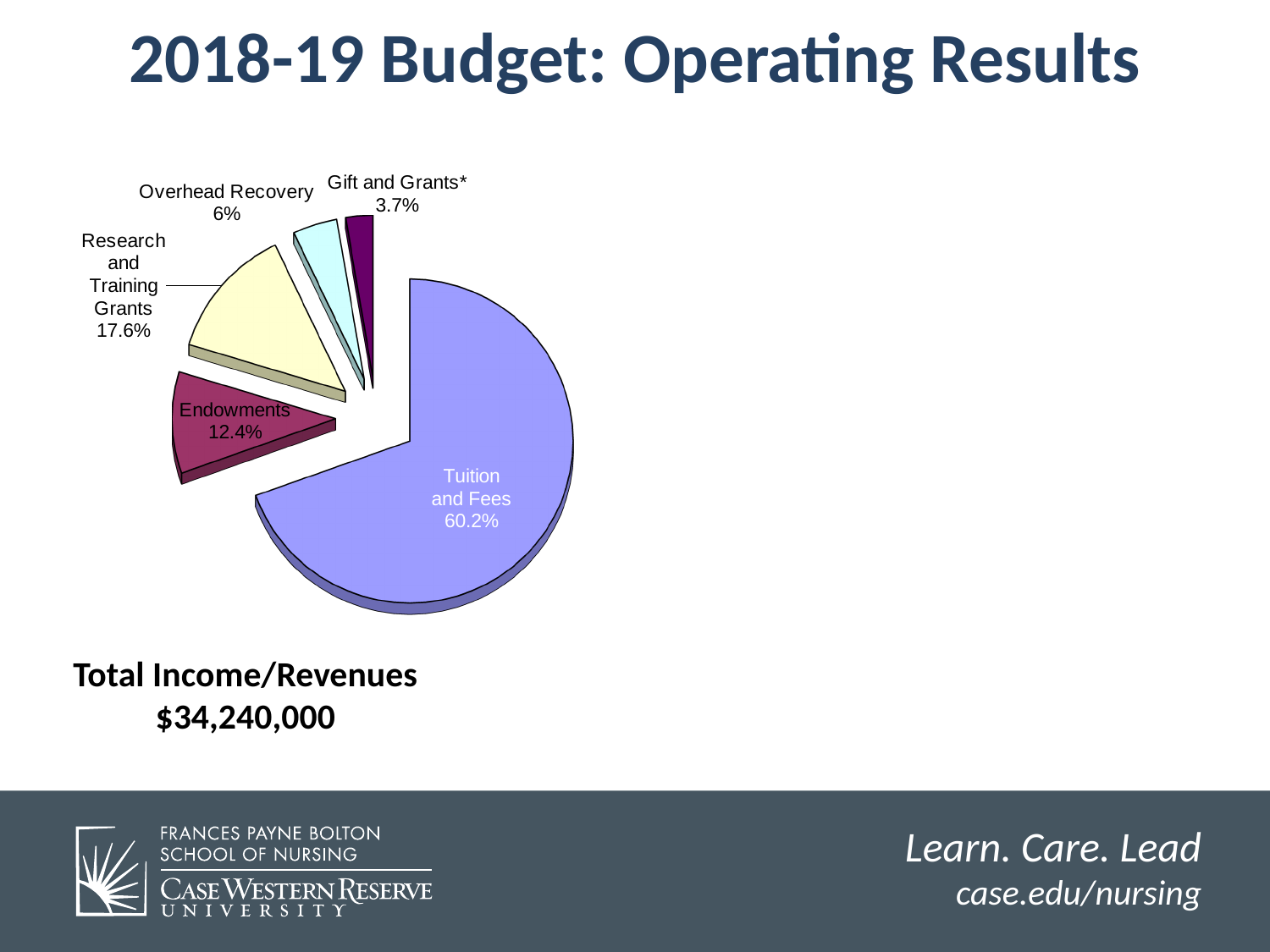
What share of the pie does Tuition and Fees represent? 60.2% What is the difference between the Research and Training Grants share and the Endowments share? 5.2% Which category has the smallest slice of the pie? Gift and Grants* What is the value shown for Research and Training Grants? 17.6% What is the value shown for Overhead Recovery? 6% Which is larger, the Overhead Recovery share or the Gift and Grants* share? Overhead Recovery What total income/revenues figure is printed below the chart? $34,240,000 Which category has the largest slice of the pie? Tuition and Fees What kind of chart is shown on the slide? pie chart How many slices does the pie chart have? 5 What is the value shown for Gift and Grants*? 3.7% What is the value shown for Endowments? 12.4%